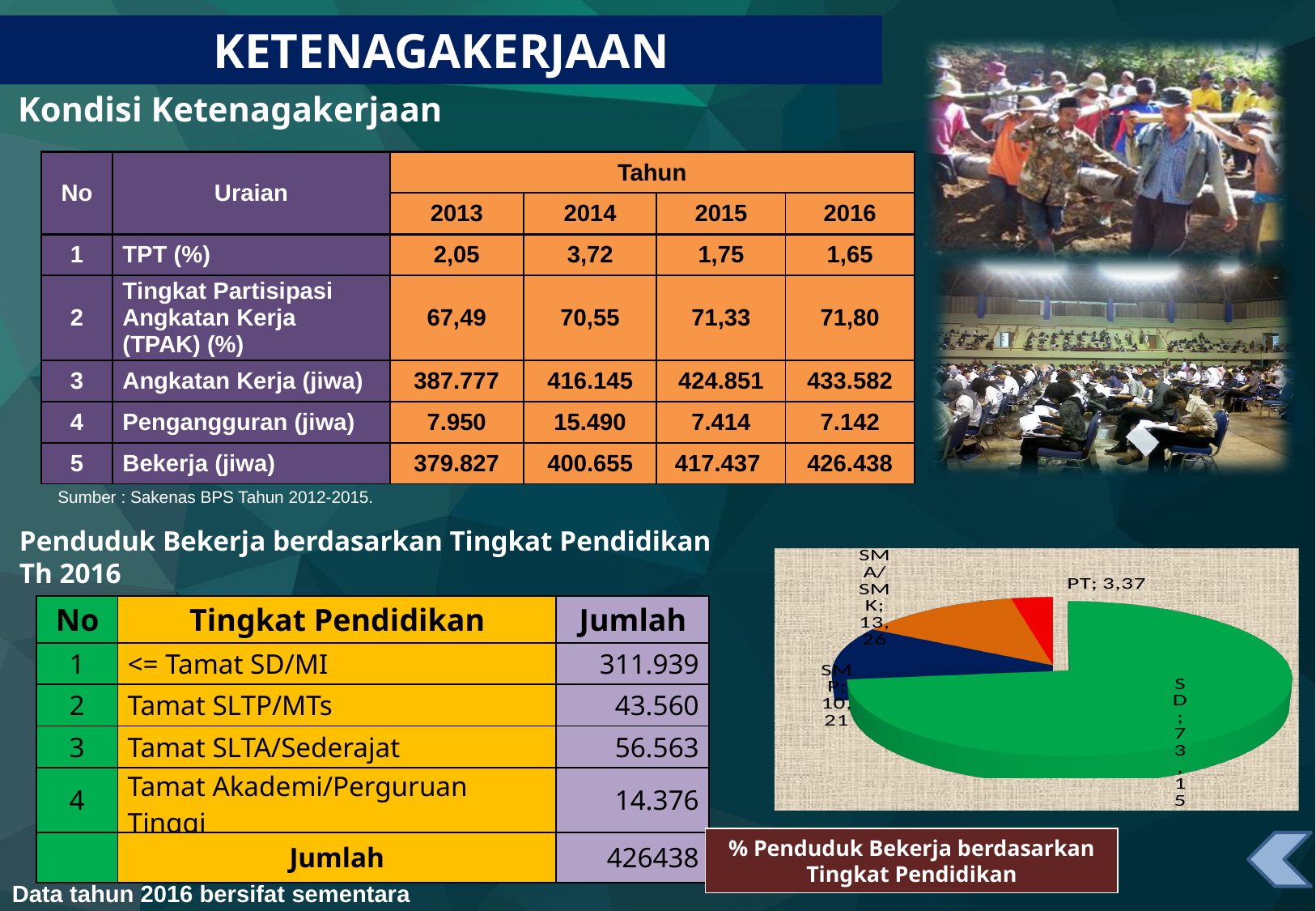
What colour is the SD slice in the pie chart? green In the pie chart, what is the difference between the values for SD and PT? 69,78 In the pie chart, what is the value for PT? 3,37 In the pie chart, what is the difference between the values for SMA/SMK and SMP? 3,05 How many slices does the pie chart have? 4 In the pie chart, what is the value for SMP? 10,21 In the pie chart, what is the value for SD? 73,15 Which category has the largest slice in the pie chart? SD Which category has the smallest slice in the pie chart? PT In the pie chart, what is the value for SMA/SMK? 13,26 What kind of chart is shown at the bottom right of the slide? pie chart In the pie chart, which is larger: SMA/SMK or SMP? SMA/SMK